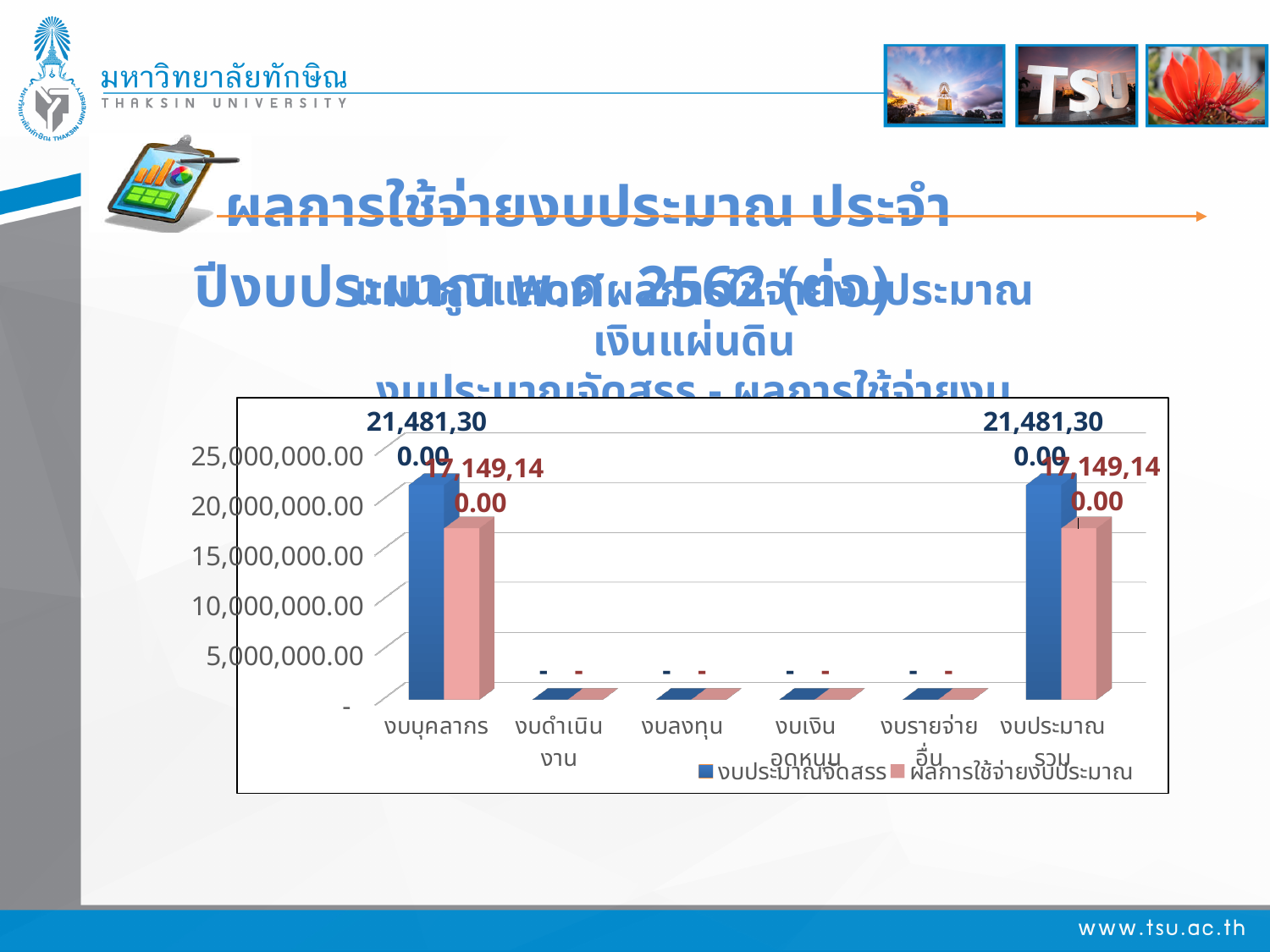
For งบบุคลากร, which is larger: งบประมาณจัดสรร or ผลการใช้จ่ายงบประมาณ? งบประมาณจัดสรร What is the งบประมาณจัดสรร value for งบบุคลากร? 21,481,300.00 How many series does the chart legend list? 2 What data label is shown for งบลงทุน in the chart? - What kind of chart is shown on the slide? bar chart Is the งบประมาณจัดสรร value for งบประมาณรวม greater or less than 20,000,000.00? greater Is the ผลการใช้จ่ายงบประมาณ value for งบบุคลากร greater or less than 20,000,000.00? less What is the difference between งบประมาณจัดสรร and ผลการใช้จ่ายงบประมาณ for งบประมาณรวม? 4,332,160.00 What are the two legend entries of the chart? งบประมาณจัดสรร and ผลการใช้จ่ายงบประมาณ How many categories in the chart show a dash (-) instead of a value for both series? 4 What is the ผลการใช้จ่ายงบประมาณ value for งบประมาณรวม? 17,149,140.00 How many categories are shown on the x axis of the chart? 6